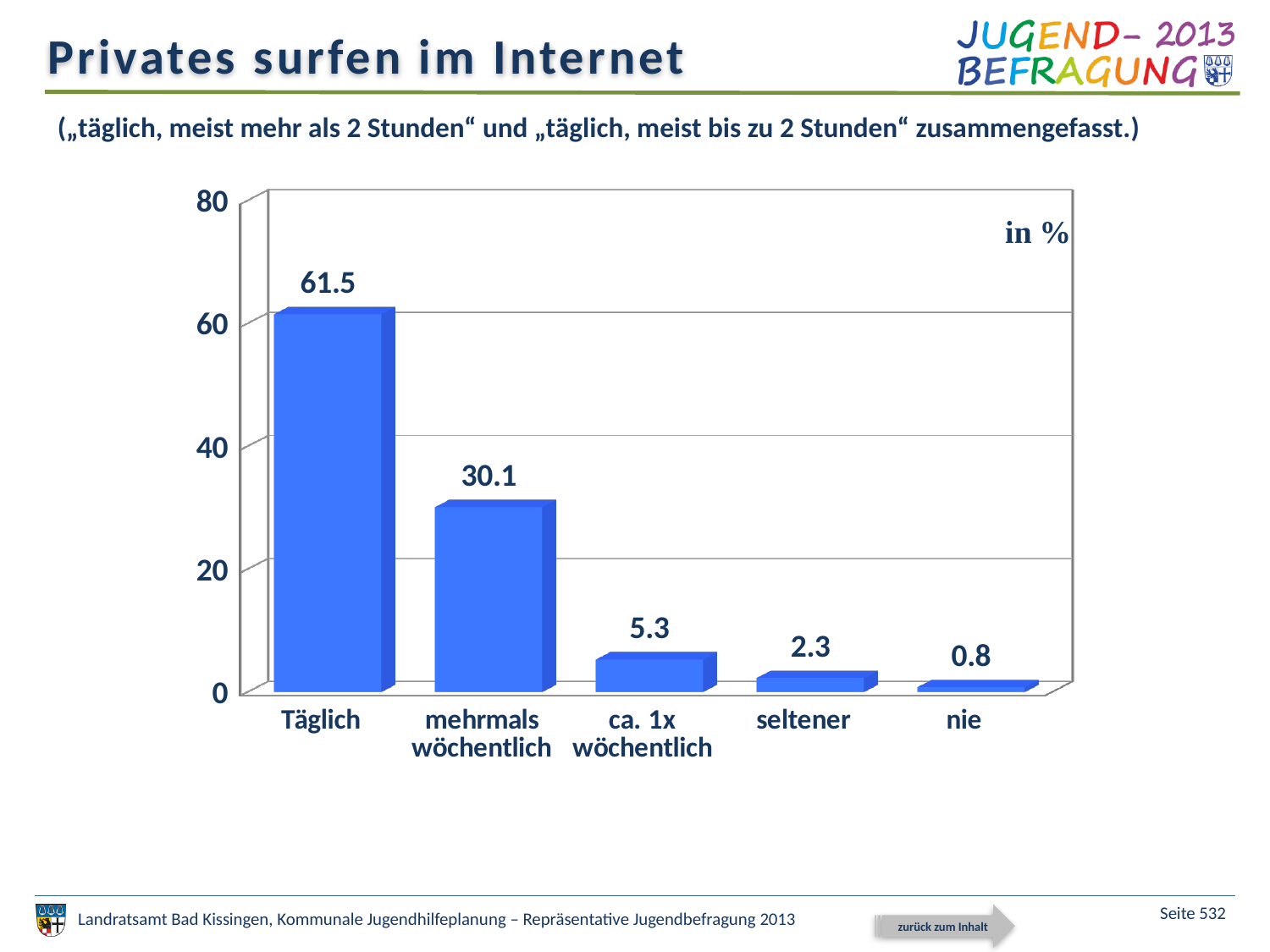
What unit is indicated in the top right corner of the chart? in % Which is larger, the value for "ca. 1x wöchentlich" or the value for "seltener"? ca. 1x wöchentlich Which category has the lowest value? nie What is the value for "mehrmals wöchentlich"? 30.1 What is the value for "Täglich"? 61.5 How many categories are shown on the x axis? 5 What kind of chart is shown on the slide? bar chart What is the value for "nie"? 0.8 What is the value for "seltener"? 2.3 What is the value for "ca. 1x wöchentlich"? 5.3 Which category has the highest value? Täglich What is the difference between the values for "Täglich" and "mehrmals wöchentlich"? 31.4